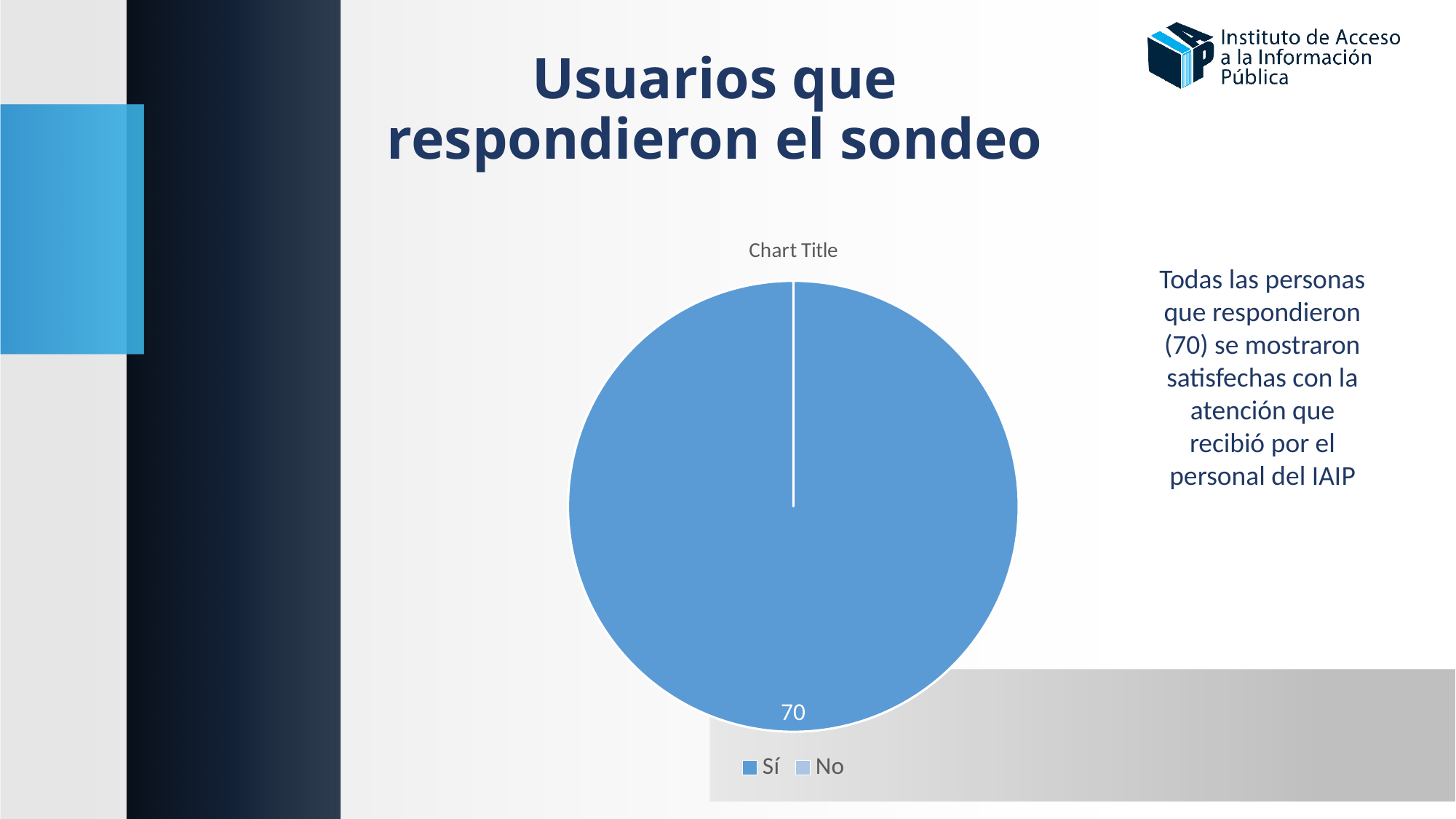
What share of the pie does the "Sí" slice take up? 100% How many entries does the legend of the pie chart list? 2 What kind of chart is shown on the slide? pie chart What are the two legend entries of the pie chart? Sí and No Which is larger in the pie chart, "Sí" or "No"? Sí What is the title printed above the pie chart? Chart Title Which category has the largest slice in the pie chart? Sí Which category has the smallest slice in the pie chart? No What is the value shown for the "Sí" slice of the pie chart? 70